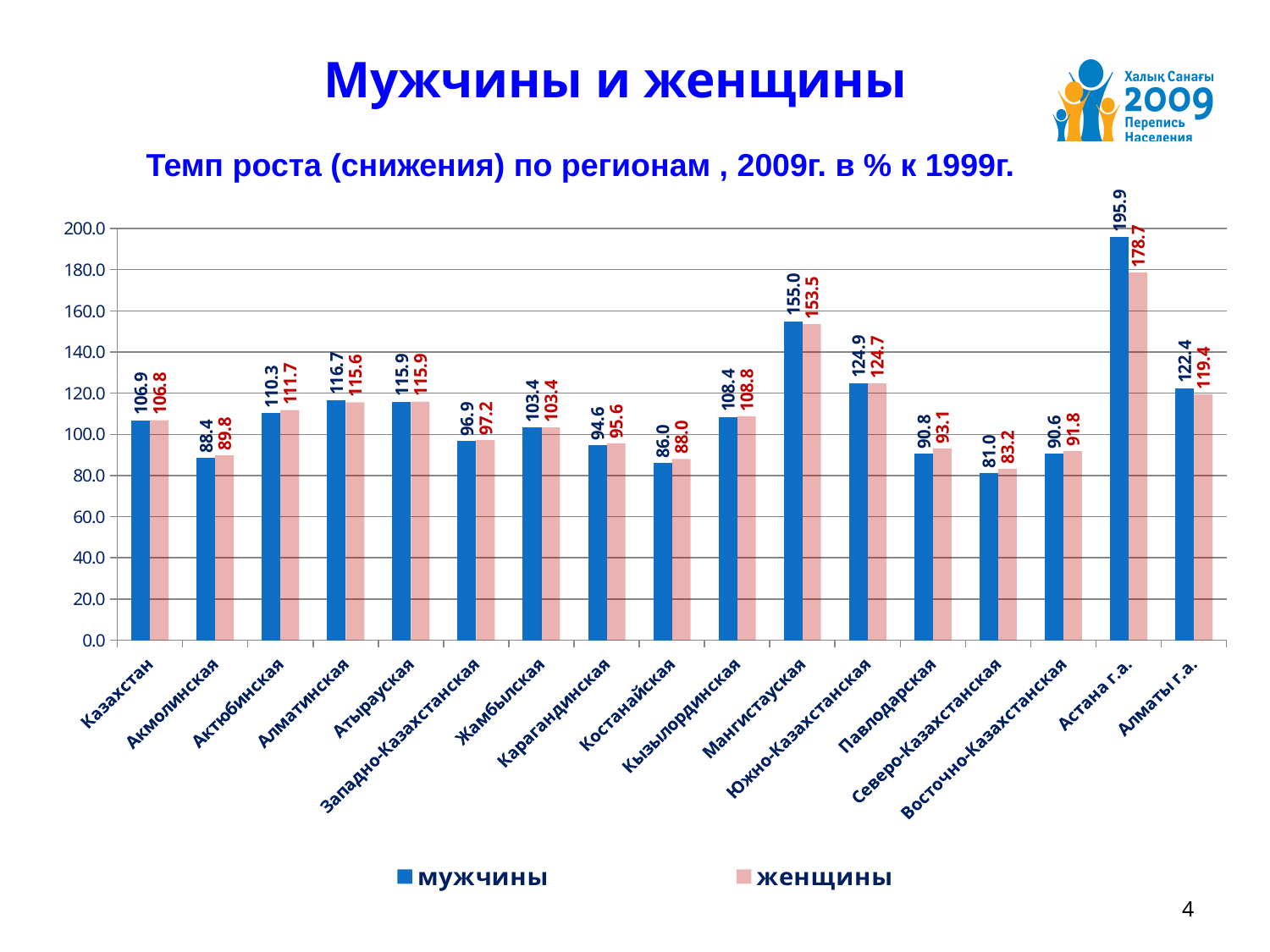
How many series does the legend list? 2 Which is larger in Павлодарская: the value for мужчины or for женщины? женщины What is the value for женщины in Мангистауская? 153.5 Is the value for мужчины in Южно-Казахстанская greater or less than 120.0? greater What is the difference between the мужчины and женщины values for Астана г.а.? 17.2 How many regions (categories) are shown on the x axis? 17 What is the value for мужчины in Астана г.а.? 195.9 Which region has the highest value for мужчины? Астана г.а. What is the value for мужчины in Северо-Казахстанская? 81.0 What is the value for женщины in Костанайская? 88.0 Which region has the lowest value for женщины? Северо-Казахстанская What kind of chart is shown on the slide? bar chart